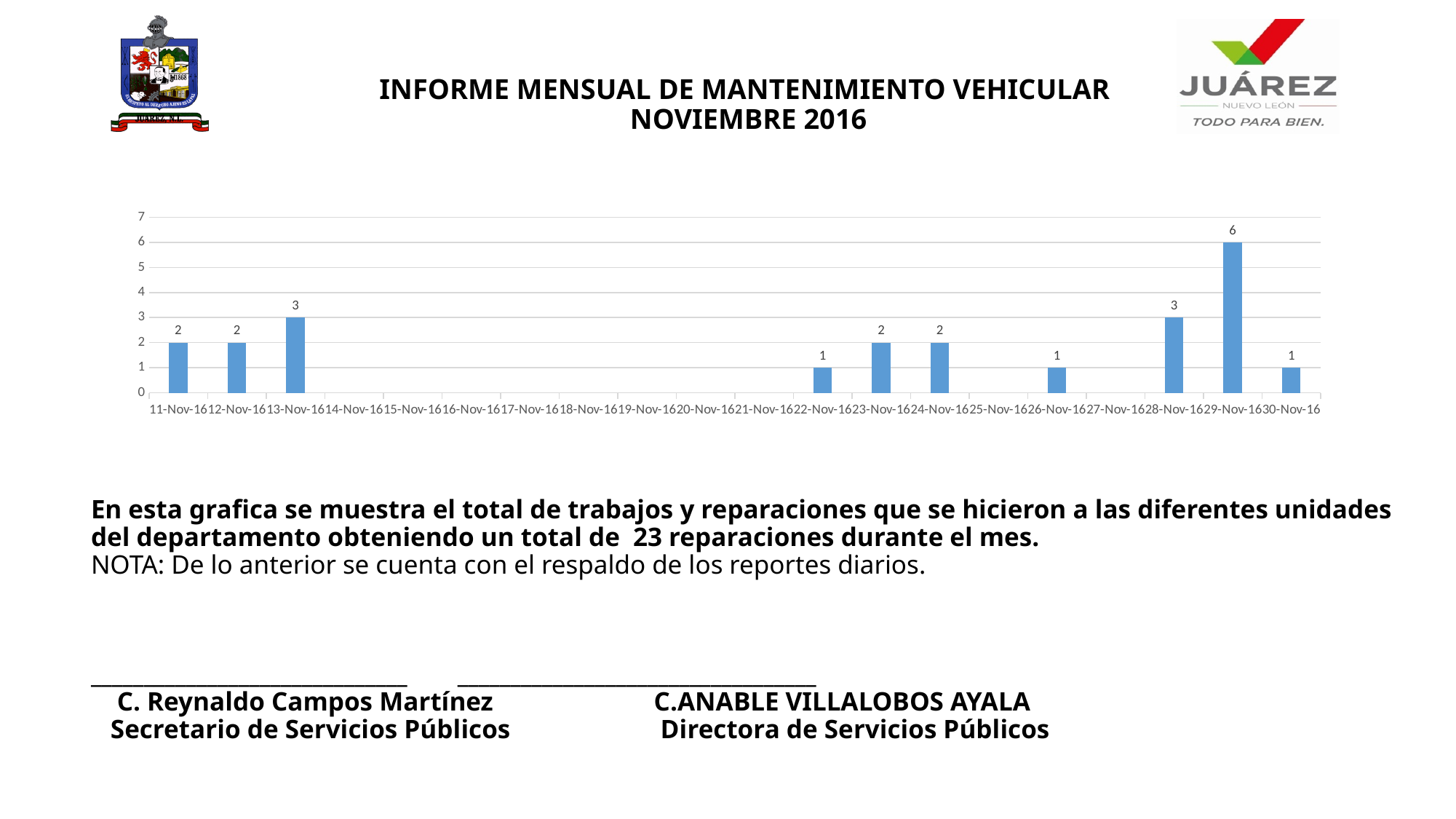
What value is shown for 13-Nov-16? 3 How many dates have a visible bar in the chart? 10 What value is shown for 29-Nov-16? 6 How many dates are labelled on the x axis? 20 What kind of chart is shown on the slide? Bar chart What is the difference between the values for 29-Nov-16 and 28-Nov-16? 3 Is the value for 29-Nov-16 greater or less than 5? greater Which is larger, the value for 23-Nov-16 or the value for 26-Nov-16? 23-Nov-16 What value is shown for 22-Nov-16? 1 What value is shown for 24-Nov-16? 2 Which date has the highest bar? 29-Nov-16 What is the difference between the values for 13-Nov-16 and 30-Nov-16? 2